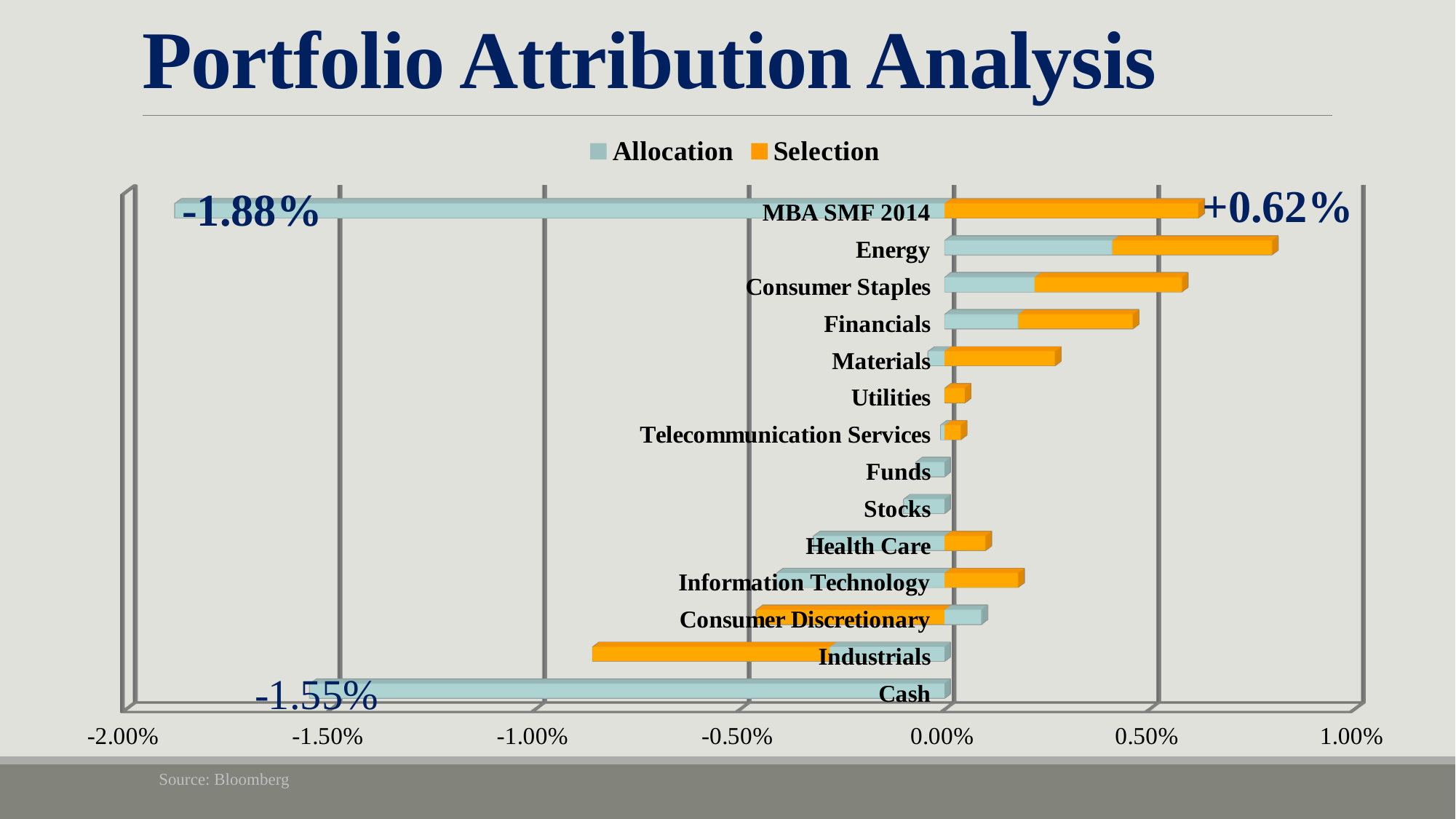
What is the Allocation value for Cash? -1.55% What is the Allocation value for MBA SMF 2014? -1.88% What kind of chart is shown on the slide? Bar chart How many categories are shown on the chart? 14 What are the two series named in the legend? Allocation and Selection What is the difference between the Selection value and the Allocation value for MBA SMF 2014? 2.50% What is the Selection value for MBA SMF 2014? +0.62% What colour represents the Selection series? Orange Which category has the lowest Allocation value? MBA SMF 2014 Is the Allocation value for Information Technology greater or less than -0.50%? greater Which is larger, the Allocation value for MBA SMF 2014 or the Allocation value for Cash? Cash How many series does the legend list? 2